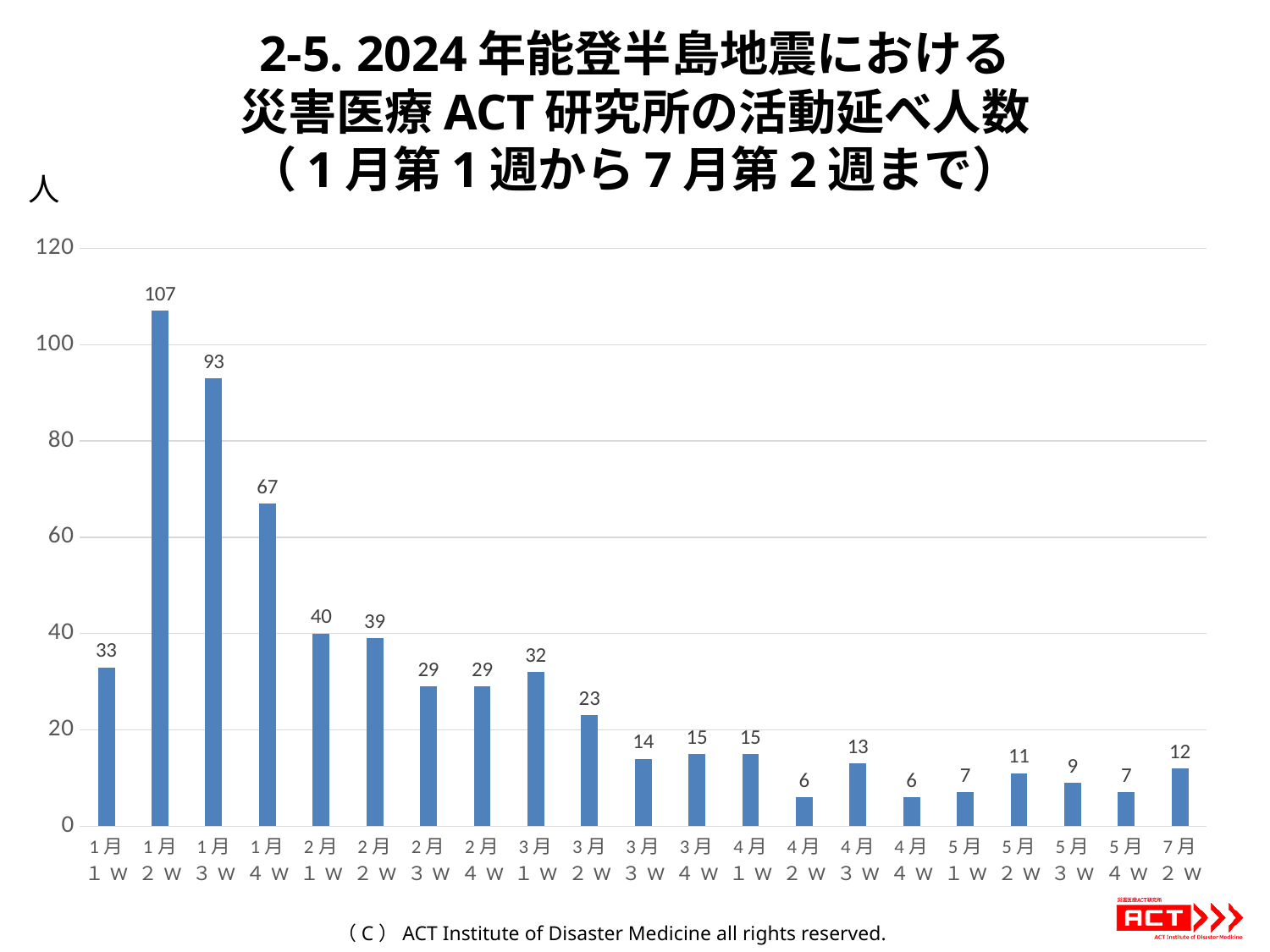
Is the value for 1月3W greater or less than 80? greater What is the value for 3月1W? 32 What is the value for 7月2W? 12 What unit label is shown above the vertical axis? 人 Which is larger, the value for 2月1W or the value for 3月2W? 2月1W What is the difference between the values for 1月4W and 2月1W? 27 Which week has the highest value? 1月2W What is the difference between the values for 1月2W and 1月3W? 14 How many bars are plotted in the chart? 21 What kind of chart is shown on the slide? bar chart What is the value for 1月2W? 107 Do the values generally rise or fall from 1月2W to 5月4W? fall